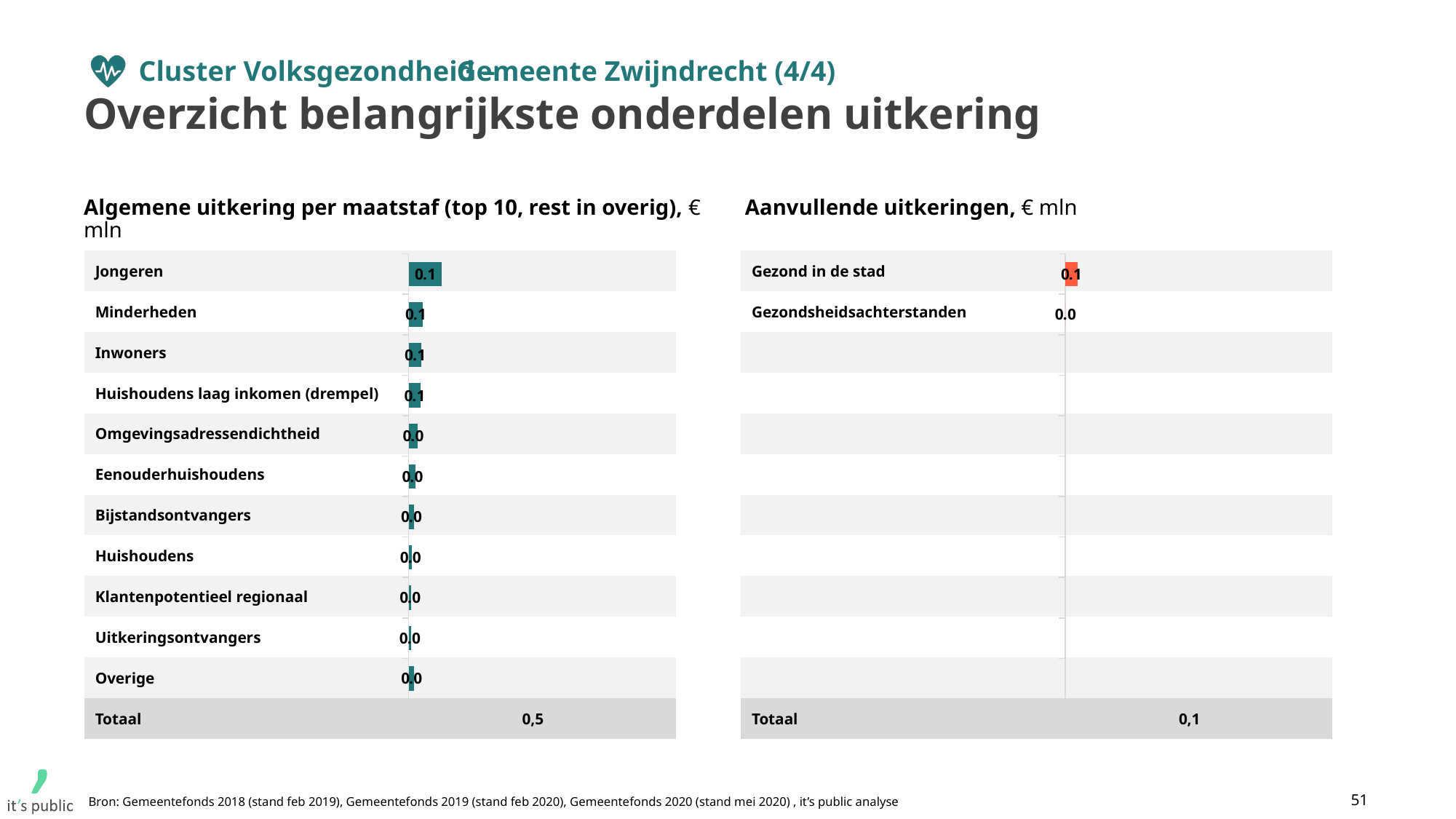
How many categories are shown in the chart 'Algemene uitkering per maatstaf'? 11 In the chart 'Aanvullende uitkeringen', which category has the highest value? Gezond in de stad In the chart 'Aanvullende uitkeringen', what is the value for Gezondsheidsachterstanden? 0.0 How many categories are shown in the chart 'Aanvullende uitkeringen'? 2 In the chart 'Aanvullende uitkeringen', what is the value for Gezond in de stad? 0.1 In the chart 'Algemene uitkering per maatstaf', what is the value for Huishoudens laag inkomen (drempel)? 0.1 What kind of chart is 'Aanvullende uitkeringen'? Bar chart In the chart 'Algemene uitkering per maatstaf', what is the value for Omgevingsadressendichtheid? 0.0 In the chart 'Algemene uitkering per maatstaf', what is the value for Jongeren? 0.1 In the chart 'Algemene uitkering per maatstaf', which category has the highest value? Jongeren In the chart 'Algemene uitkering per maatstaf', which is larger: Jongeren or Overige? Jongeren What is the Totaal shown for the chart 'Algemene uitkering per maatstaf'? 0,5